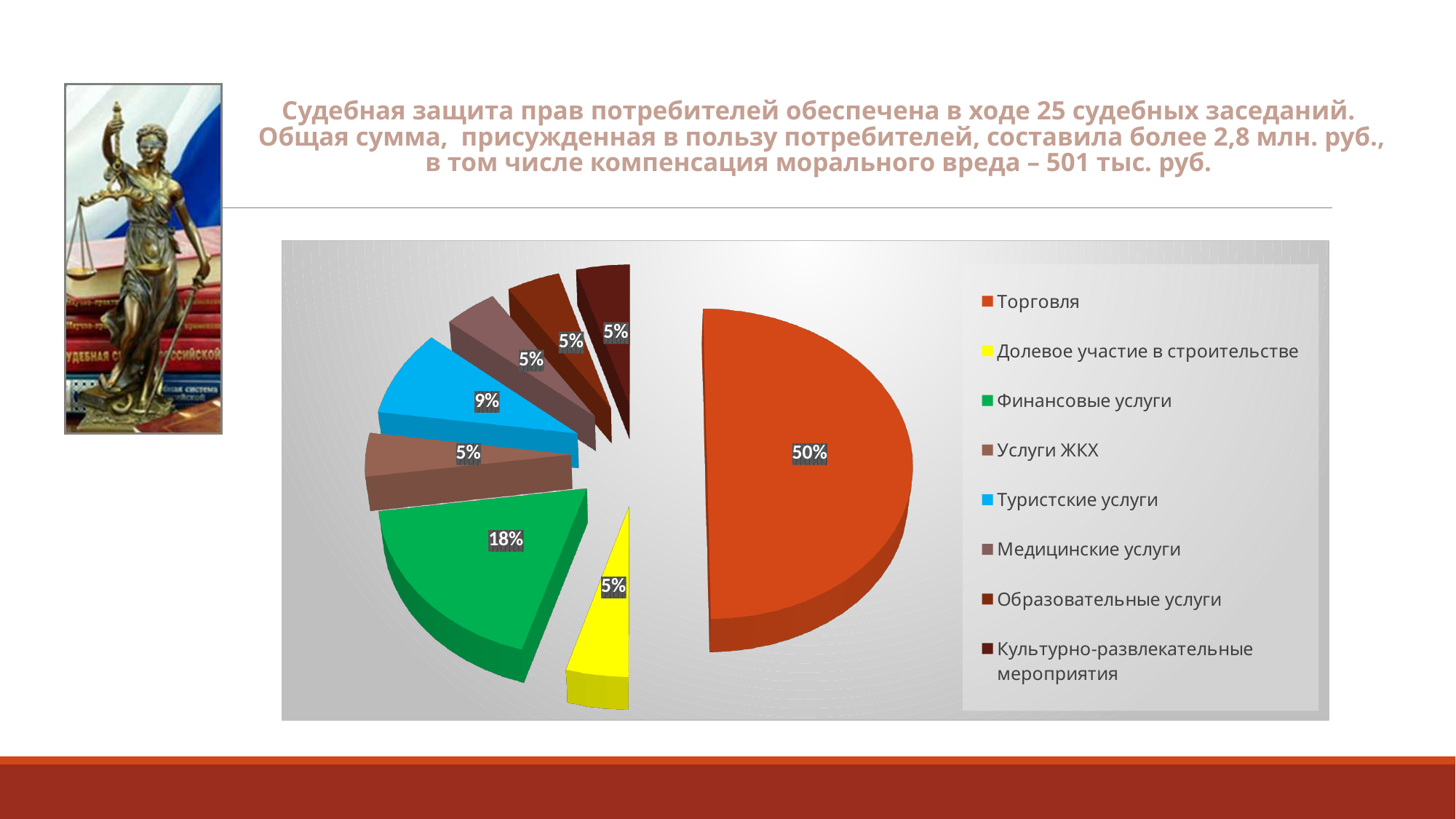
What kind of chart is shown on the slide? Pie chart What is the value shown for Финансовые услуги? 18% Which is larger, the share of Туристские услуги or the share of Медицинские услуги? Туристские услуги What is the value shown for Услуги ЖКХ? 5% What colour is the slice for Финансовые услуги? Green What share of the pie does Торговля account for? 50% Which category has the largest slice of the pie? Торговля How many categories does the pie chart show? 8 What is the difference between the shares of Финансовые услуги and Туристские услуги? 9% What is the value shown for Долевое участие в строительстве? 5% What is the value shown for Туристские услуги? 9% What is the difference between the shares of Торговля and Финансовые услуги? 32%